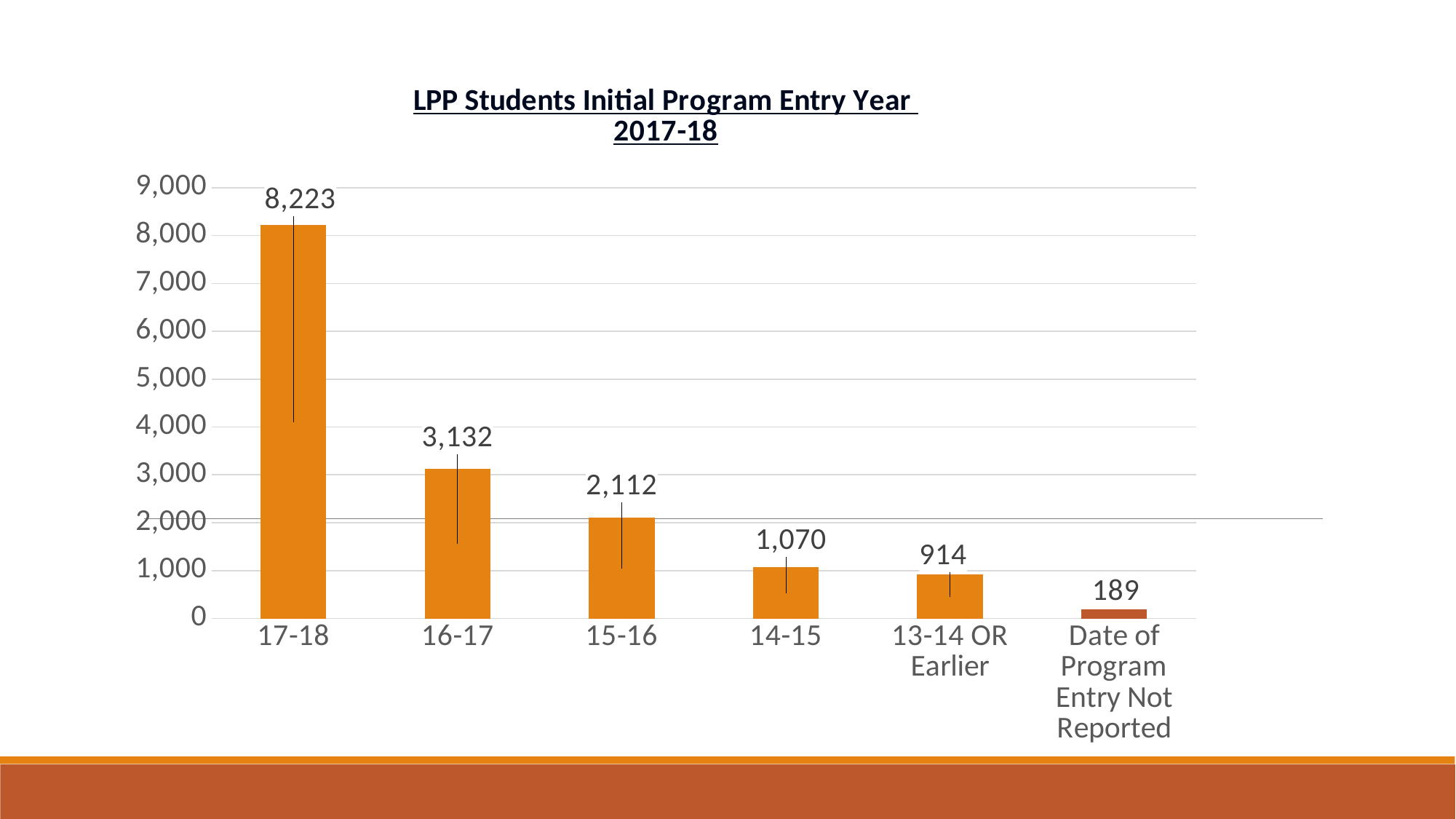
What is the value for 17-18? 8,223 What is the value for Date of Program Entry Not Reported? 189 Which category has the lowest value? Date of Program Entry Not Reported Do the values rise or fall from 17-18 to Date of Program Entry Not Reported along the x axis? fall What is the value for 15-16? 2,112 What kind of chart is this? bar chart What is the title of the chart? LPP Students Initial Program Entry Year 2017-18 What is the difference between the values for 17-18 and 16-17? 5,091 How many categories are shown on the x axis? 6 Is the value for 16-17 greater or less than 3,000? greater Which is larger, the value for 14-15 or the value for 13-14 OR Earlier? 14-15 Which category has the highest value? 17-18